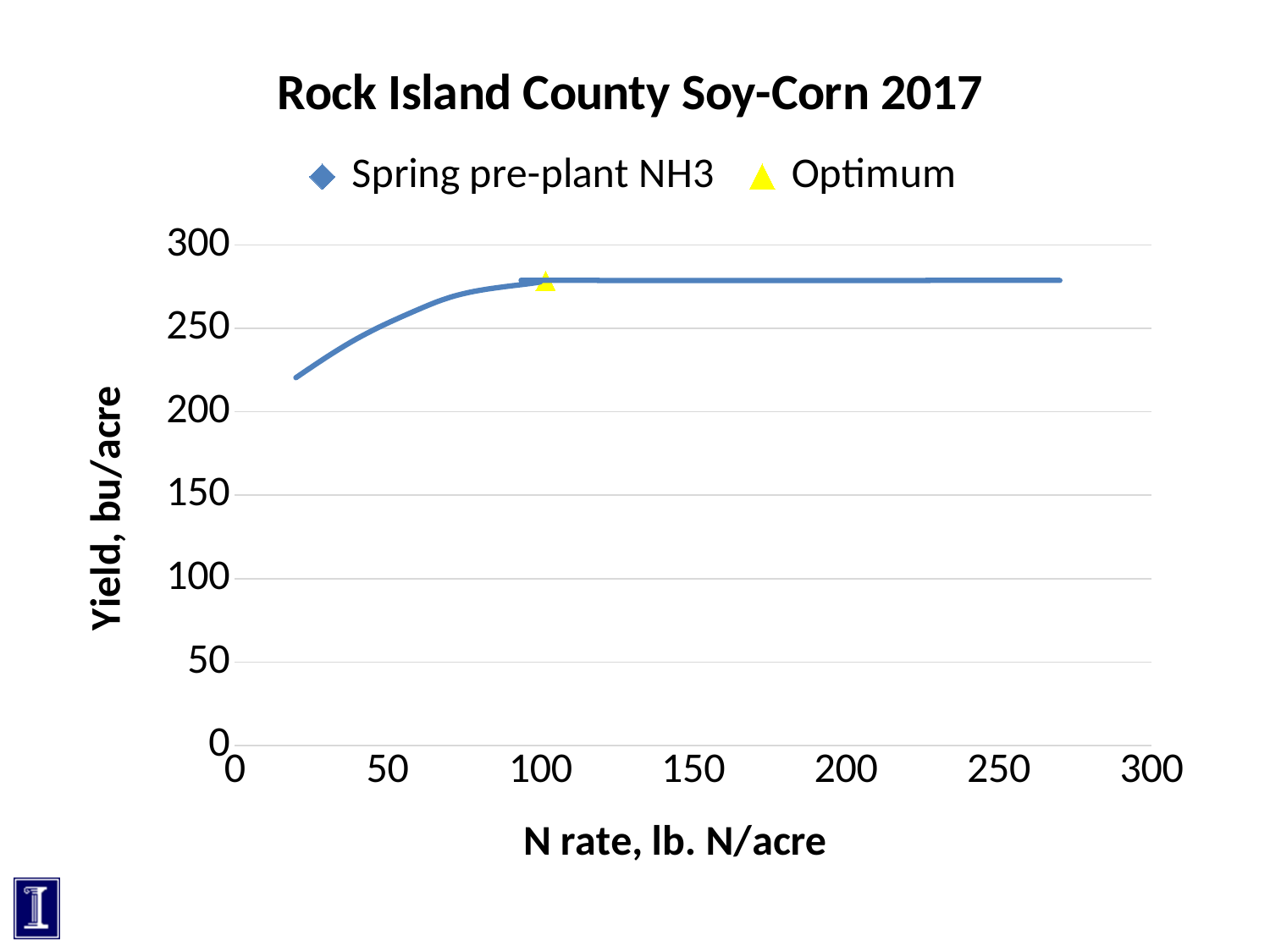
Is the Spring pre-plant NH3 yield at an N rate of 100 lb. N/acre greater or less than 250? greater Is the Spring pre-plant NH3 yield at an N rate of 250 greater or less than 300? less What kind of chart is shown on the slide? line chart Is the Spring pre-plant NH3 yield at the lowest plotted N rate greater or less than 200? greater Which is larger for Spring pre-plant NH3: the yield at an N rate of 50 or the yield at an N rate of 200? 200 Does the yield for Spring pre-plant NH3 rise or fall as the N rate increases from 20 to 100 lb. N/acre? rise What is the label of the y axis? Yield, bu/acre What is the title of the chart? Rock Island County Soy-Corn 2017 How many series does the chart legend list? 2